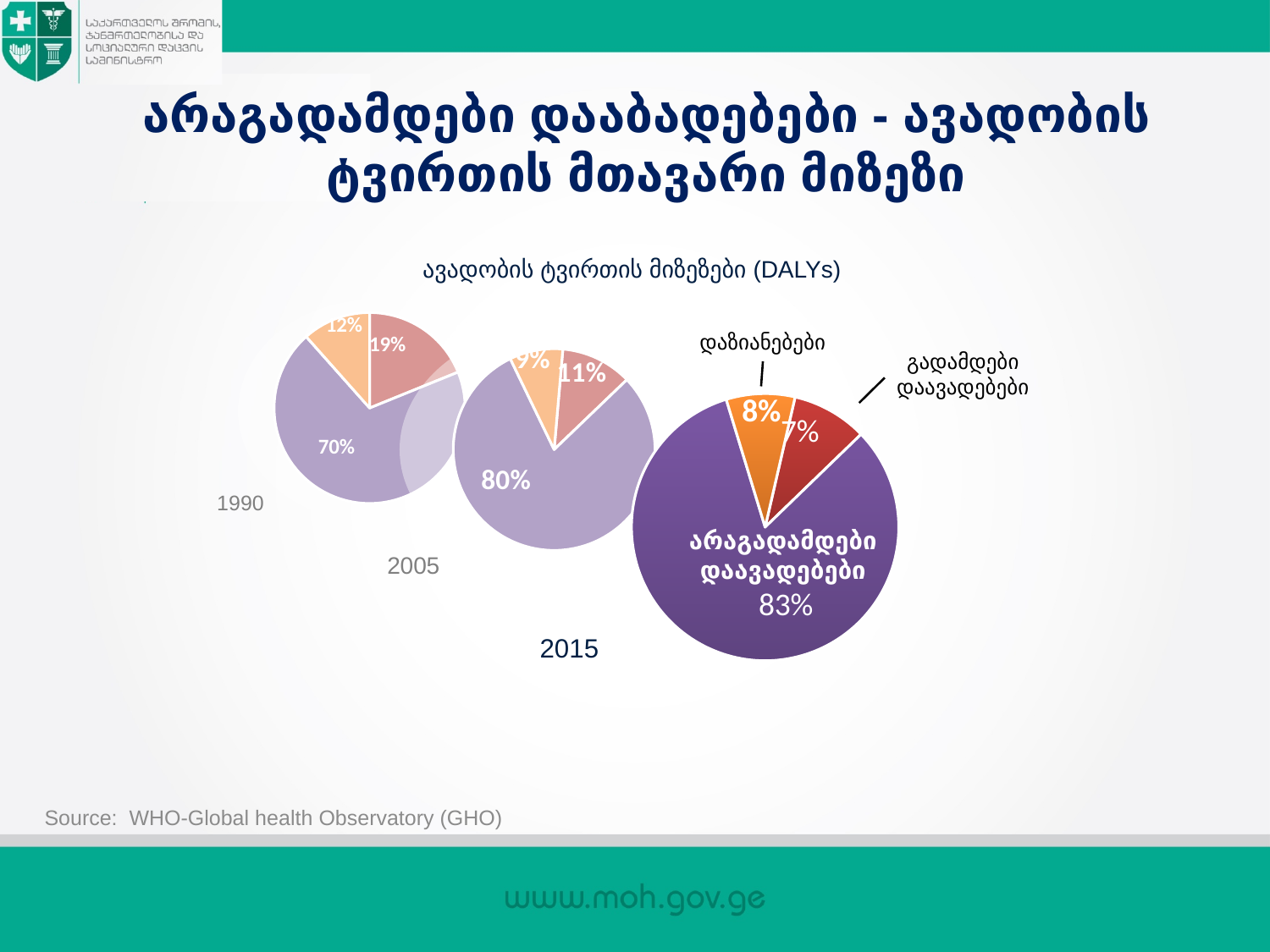
In the 1990 pie chart, what is the largest slice's share? 70% In the 2015 pie chart, what share is labelled for დაზიანებები (injuries)? 8% What is the title shown above the pie charts? ავადობის ტვირთის მიზეზები (DALYs) In the 2005 pie chart, what is the smallest slice's share? 9% In the 1990 pie chart, what is the smallest slice's share? 12% How many pie charts are shown on the slide? 3 By how many percentage points did the largest slice grow from the 1990 pie chart (70%) to the 2015 pie chart (83%)? 13 percentage points In the 2015 pie chart, what share is labelled for არაგადამდები დაავადებები (noncommunicable diseases)? 83% In the 2015 pie chart, what share is labelled for გადამდები დაავადებები (communicable diseases)? 7% In the 2005 pie chart, what is the largest slice's share? 80% What kind of charts are shown on the slide? Pie charts Does the share of the largest slice rise or fall across the 1990, 2005 and 2015 pie charts? Rise